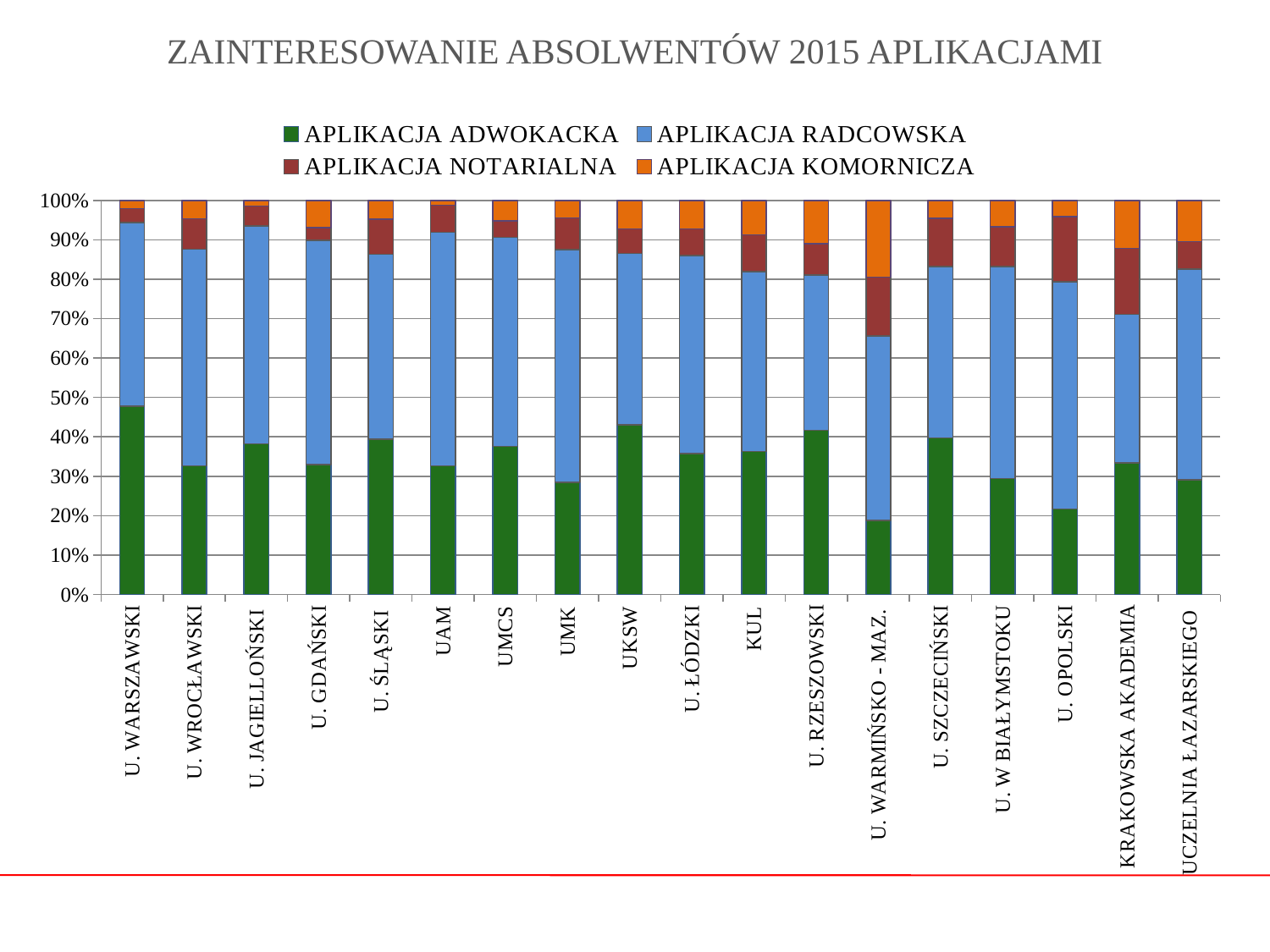
Is the APLIKACJA ADWOKACKA share for U. WARMIŃSKO - MAZ. greater or less than 30%? less How many universities (categories) are shown on the x axis? 18 What is the title of the chart? ZAINTERESOWANIE ABSOLWENTÓW 2015 APLIKACJAMI Is the APLIKACJA ADWOKACKA share for U. WARSZAWSKI greater or less than 40%? greater How many series does the legend list? 4 Is the APLIKACJA ADWOKACKA share for U. OPOLSKI greater or less than 30%? less Which has the larger APLIKACJA ADWOKACKA share, U. WARSZAWSKI or U. WROCŁAWSKI? U. WARSZAWSKI Which university has the largest APLIKACJA ADWOKACKA share? U. WARSZAWSKI What is the total height of each stacked bar on the y axis? 100% What kind of chart is shown on the slide? Stacked bar chart Which university has the largest APLIKACJA KOMORNICZA share? U. WARMIŃSKO - MAZ. Which series is shown in green in the legend? APLIKACJA ADWOKACKA